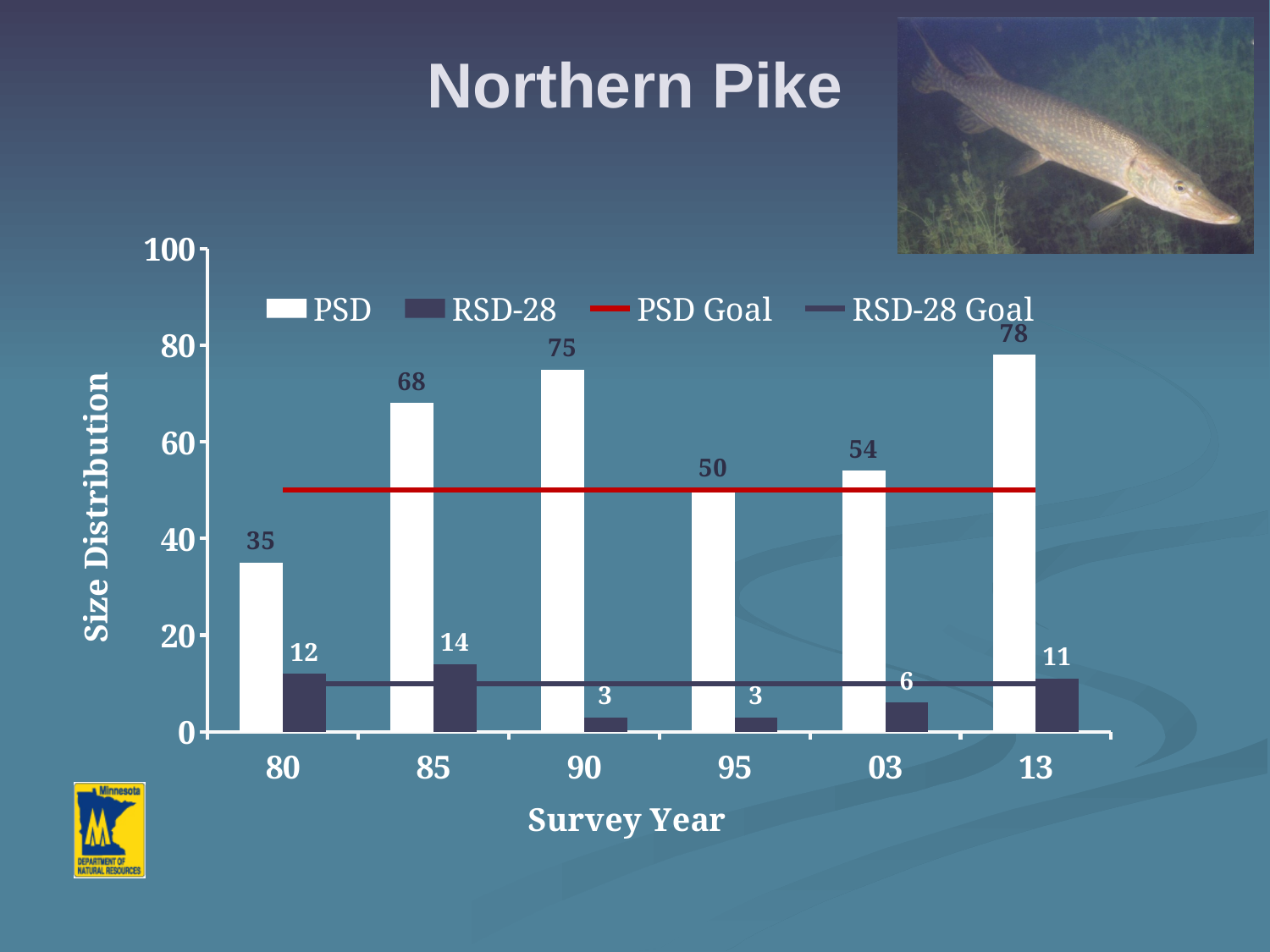
What is the RSD-28 value for survey year 85? 14 Which is larger, the RSD-28 value for survey year 80 or for survey year 13? 80 How many series does the legend list? 4 Which survey year has the highest PSD value? 13 What is the PSD value for survey year 80? 35 How many survey years are shown on the x axis? 6 What kind of chart is shown on the slide? combination bar and line chart What is the PSD value for survey year 90? 75 What is the difference between the PSD values for survey years 13 and 03? 24 Is the PSD Goal line greater or less than 60? less What is the label of the y axis? Size Distribution Which survey year has the lowest PSD value? 80